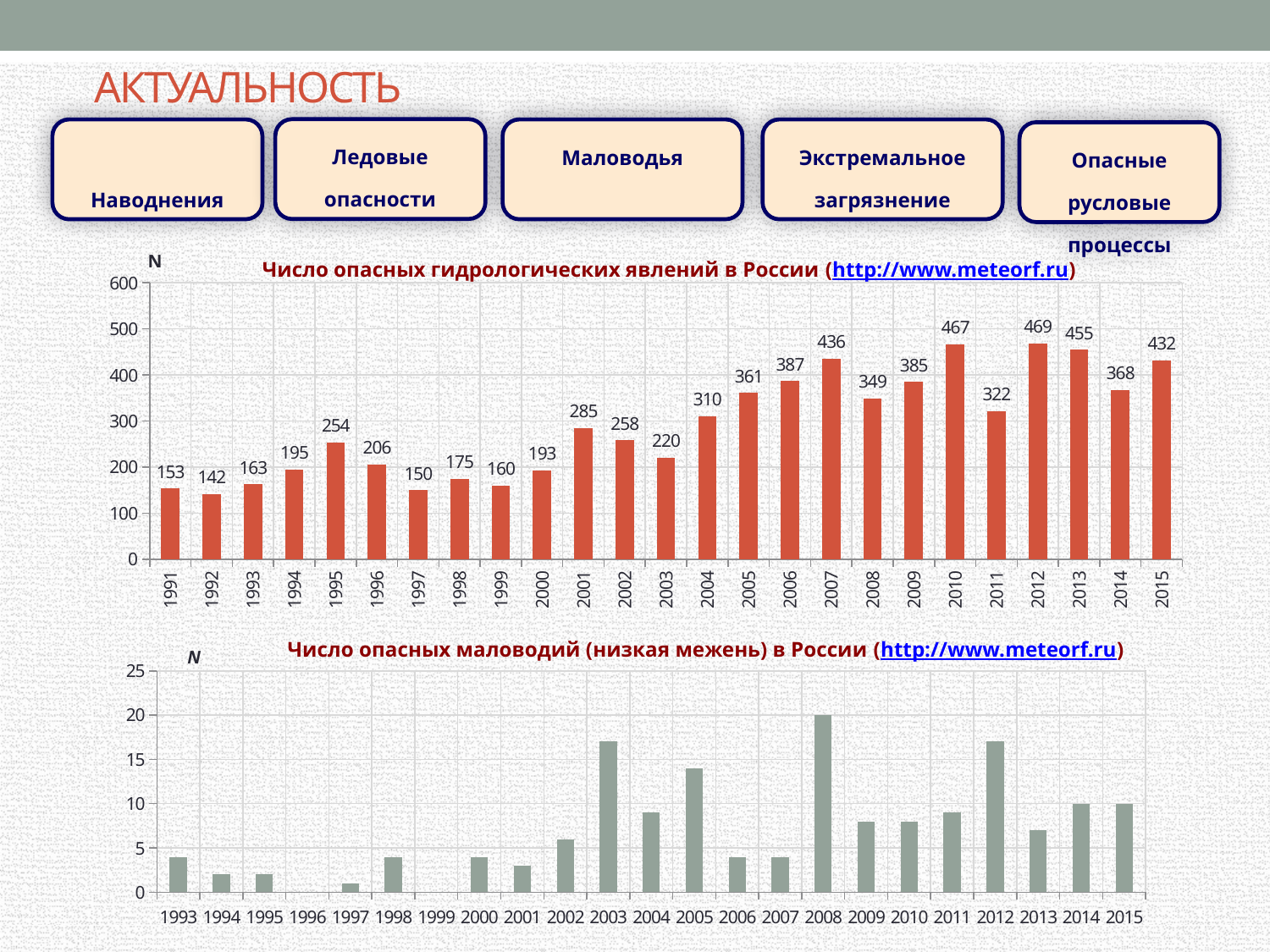
In the top chart 'Число опасных гидрологических явлений в России', which is larger, the value for 2005 or the value for 2008? 2005 What kind of chart is the bottom chart 'Число опасных маловодий (низкая межень) в России'? bar chart In the bottom chart 'Число опасных маловодий (низкая межень) в России', is the value for 2001 greater or less than 5? less In the top chart 'Число опасных гидрологических явлений в России', which year has the highest value? 2012 In the top chart 'Число опасных гидрологических явлений в России', what is the value for 1997? 150 In the bottom chart 'Число опасных маловодий (низкая межень) в России', is the value for 2003 greater or less than 15? greater In the top chart 'Число опасных гидрологических явлений в России', do the values generally rise or fall from 1991 to 2015? rise In the bottom chart 'Число опасных маловодий (низкая межень) в России', which year has the highest value? 2008 In the top chart 'Число опасных гидрологических явлений в России', what is the difference between the values for 2012 and 2011? 147 In the top chart 'Число опасных гидрологических явлений в России', what is the value for 2010? 467 In the top chart 'Число опасных гидрологических явлений в России', which year has the lowest value? 1992 In the top chart 'Число опасных гидрологических явлений в России', how many years are shown on the x axis? 25